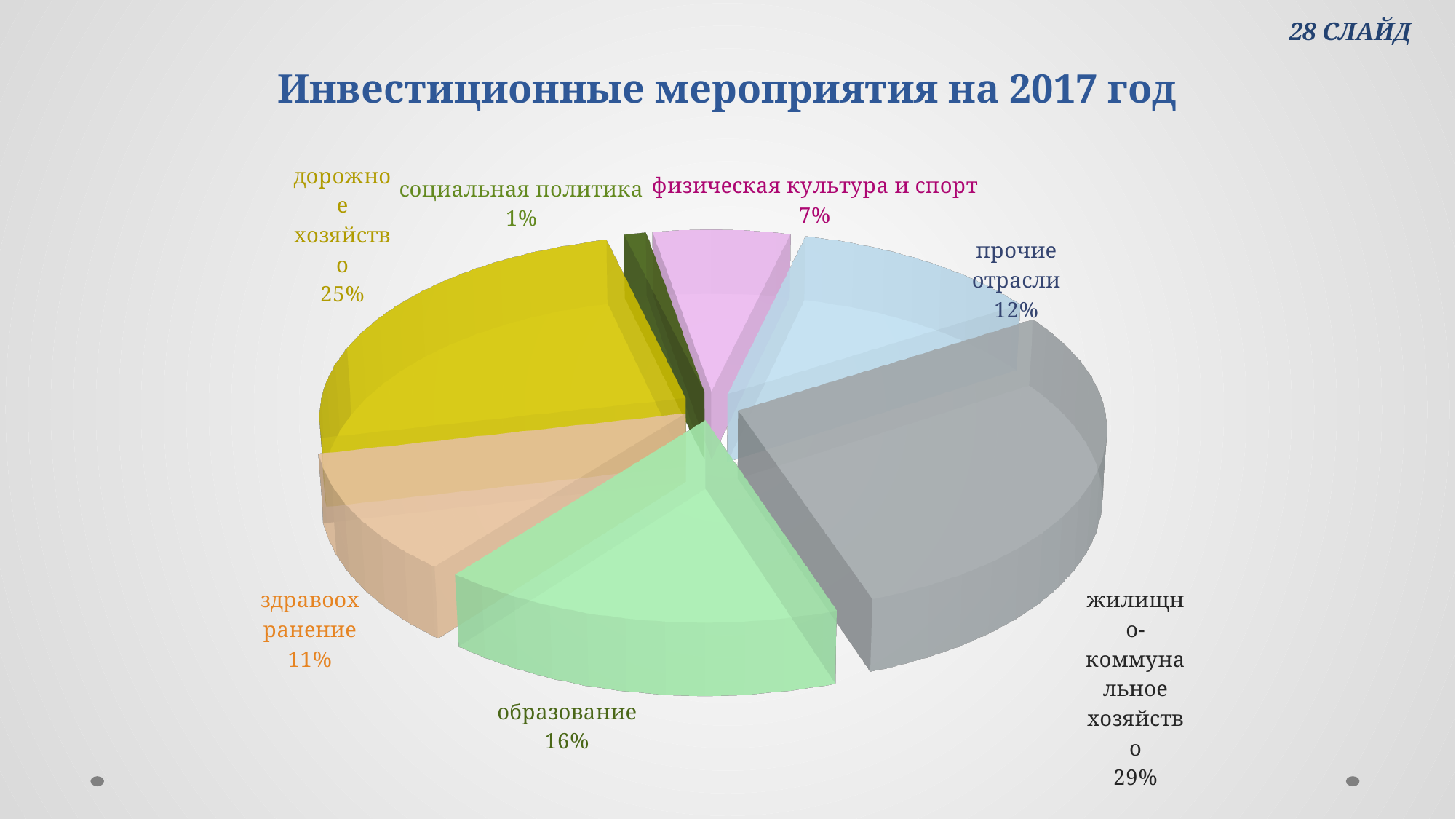
What is the difference between the shares of жилищно-коммунальное хозяйство and дорожное хозяйство? 4% How many categories are shown in the pie chart? 7 What is the title of the chart? Инвестиционные мероприятия на 2017 год What is the value shown for дорожное хозяйство? 25% What percentage is shown for образование? 16% Which category has the smallest slice of the pie? социальная политика Which is larger, the share for прочие отрасли or the share for здравоохранение? прочие отрасли What share is labelled for физическая культура и спорт? 7% What is the value for здравоохранение? 11% What share of the pie does жилищно-коммунальное хозяйство have? 29% Which category has the largest slice of the pie? жилищно-коммунальное хозяйство What type of chart is shown on the slide? pie chart